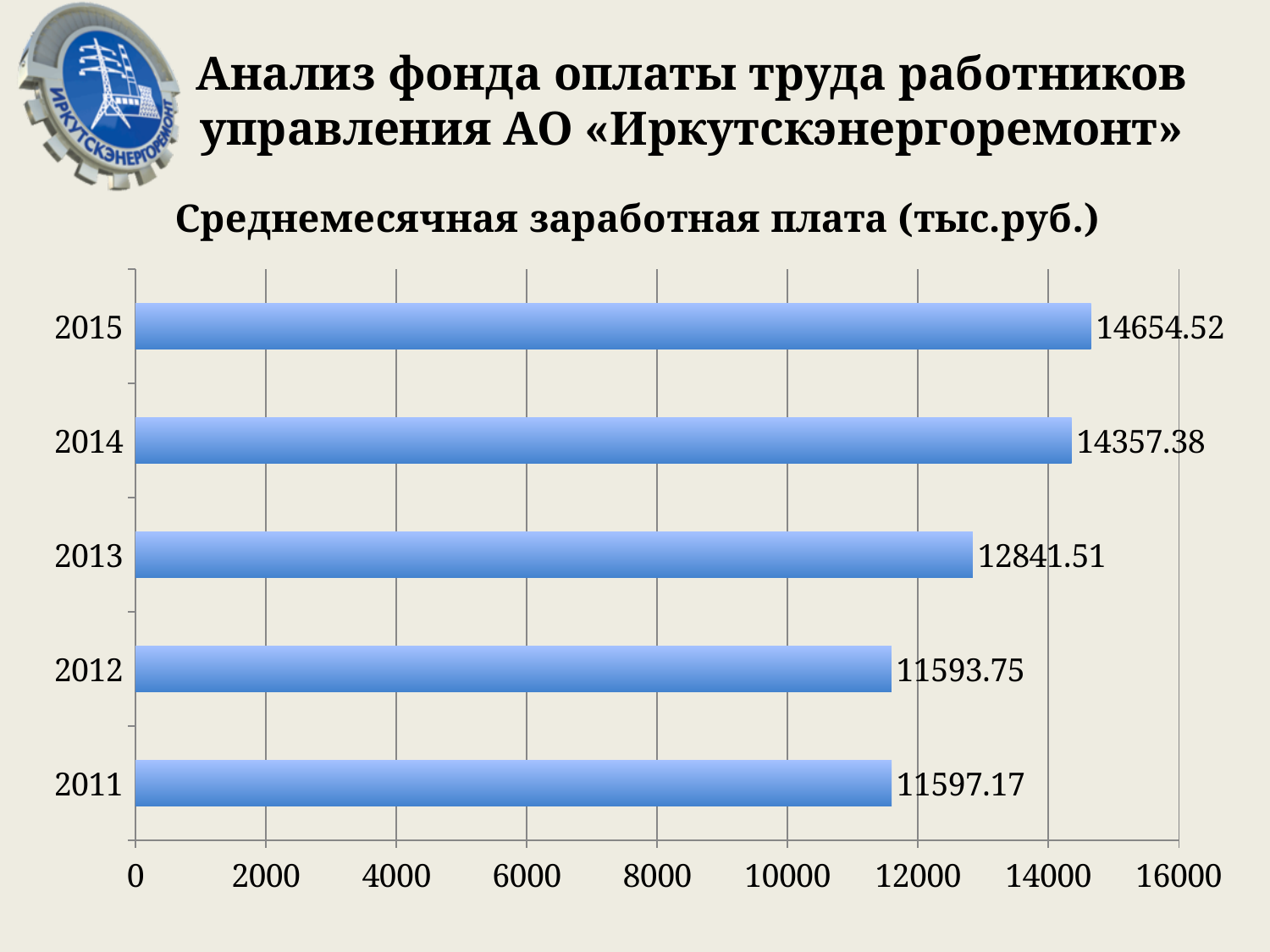
Is the value for 2012 greater or less than 12000? less What value is shown for 2013? 12841.51 Is the value for 2013 greater or less than 12000? greater What value is shown for 2011? 11597.17 Which year has the highest average monthly salary? 2015 Which is larger, the value for 2014 or the value for 2013? 2014 What is the average monthly salary shown for 2015? 14654.52 What is the title of the chart? Среднемесячная заработная плата (тыс.руб.) What is the difference between the values for 2015 and 2014? 297.14 What is the difference between the values for 2013 and 2012? 1247.76 What kind of chart is shown on the slide? bar chart How many years are shown in the chart? 5